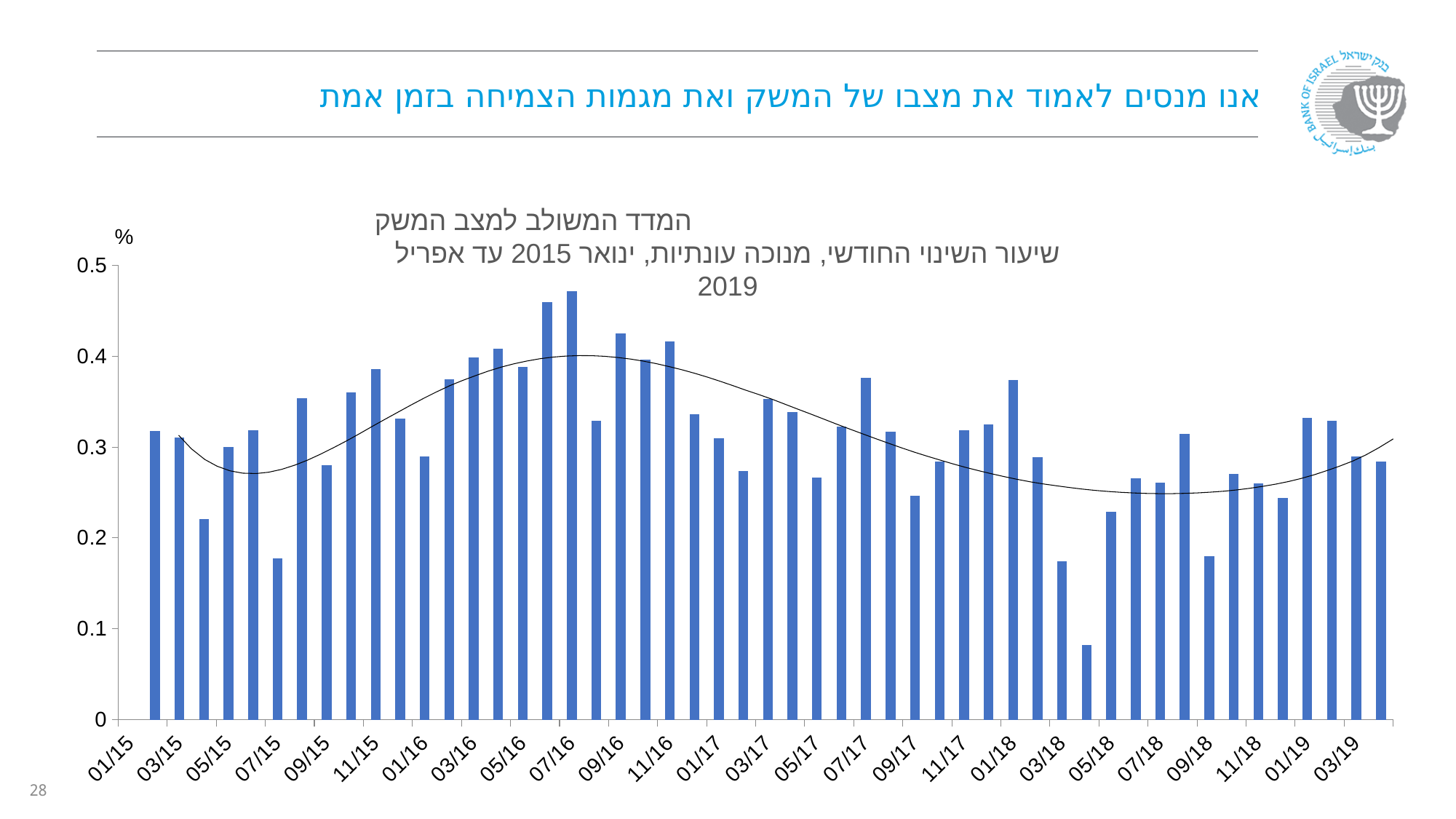
Is the value for 07/17 greater or less than 0.4? less What kind of chart is shown on the slide? bar chart Is the value for 01/19 greater or less than 0.3? greater Is the value for 03/18 greater or less than 0.2? less Does the smooth trend line rise or fall between 07/16 and 05/18? fall What is the highest value shown on the y axis? 0.5 Which has the larger value, 07/16 or 03/18? 07/16 What unit is shown at the top of the y axis? %